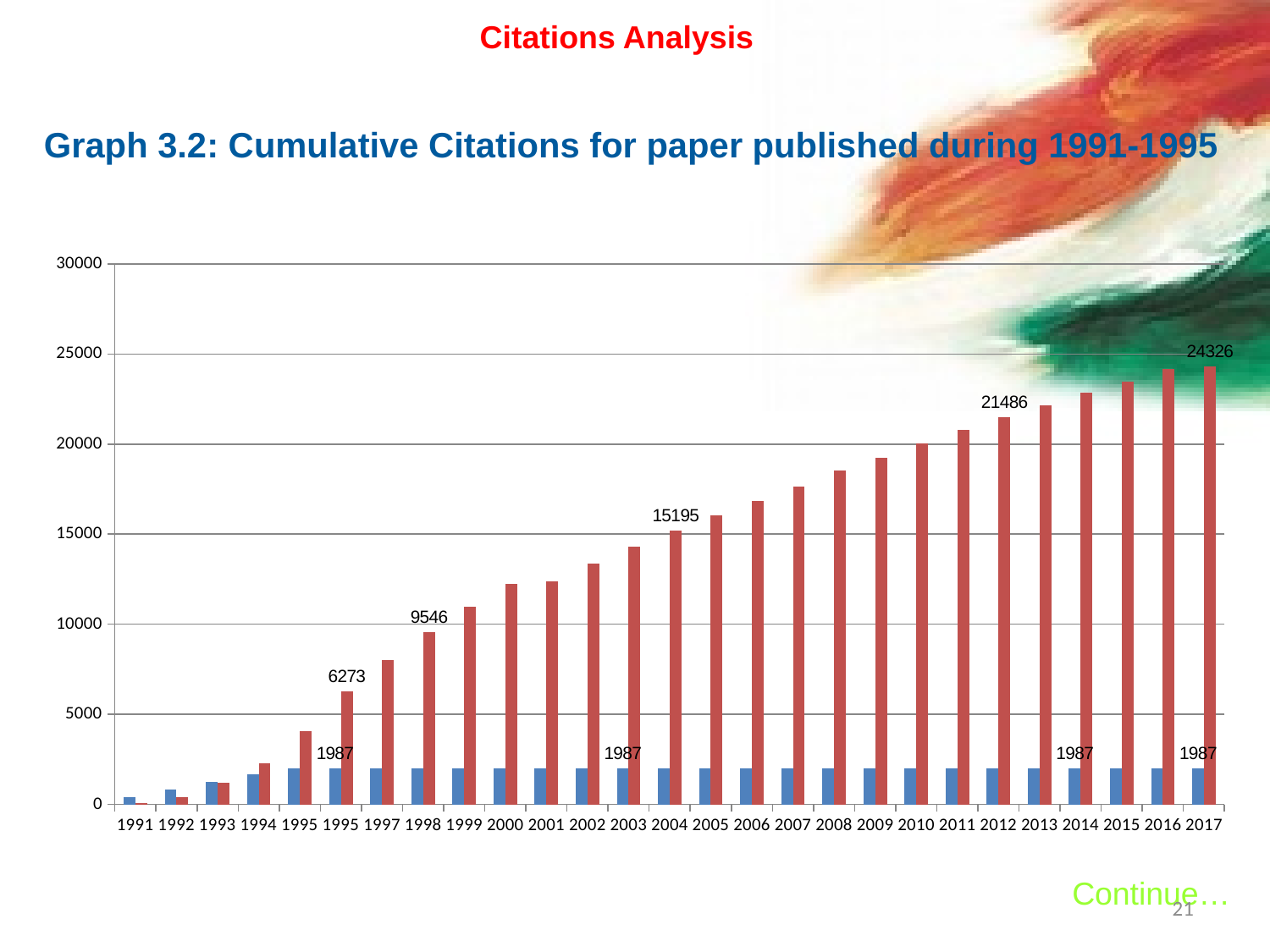
What is the difference between the red bar and the blue bar for 2017? 22339 Is the red bar value for 2009 greater or less than 20000? less What is the value of the red bar for 1998? 9546 What kind of chart is shown on the slide? bar chart What is the value of the blue bar for 2014? 1987 What is the value of the red bar for 2017? 24326 What is the value of the red bar for 2004? 15195 What is the difference between the red bar values for 2017 and 2012? 2840 Is the red bar value for 2007 greater or less than 15000? greater Which year has the highest red bar? 2017 What is the value of the red bar for 2012? 21486 What is the difference between the red bar values for 2004 and 1998? 5649